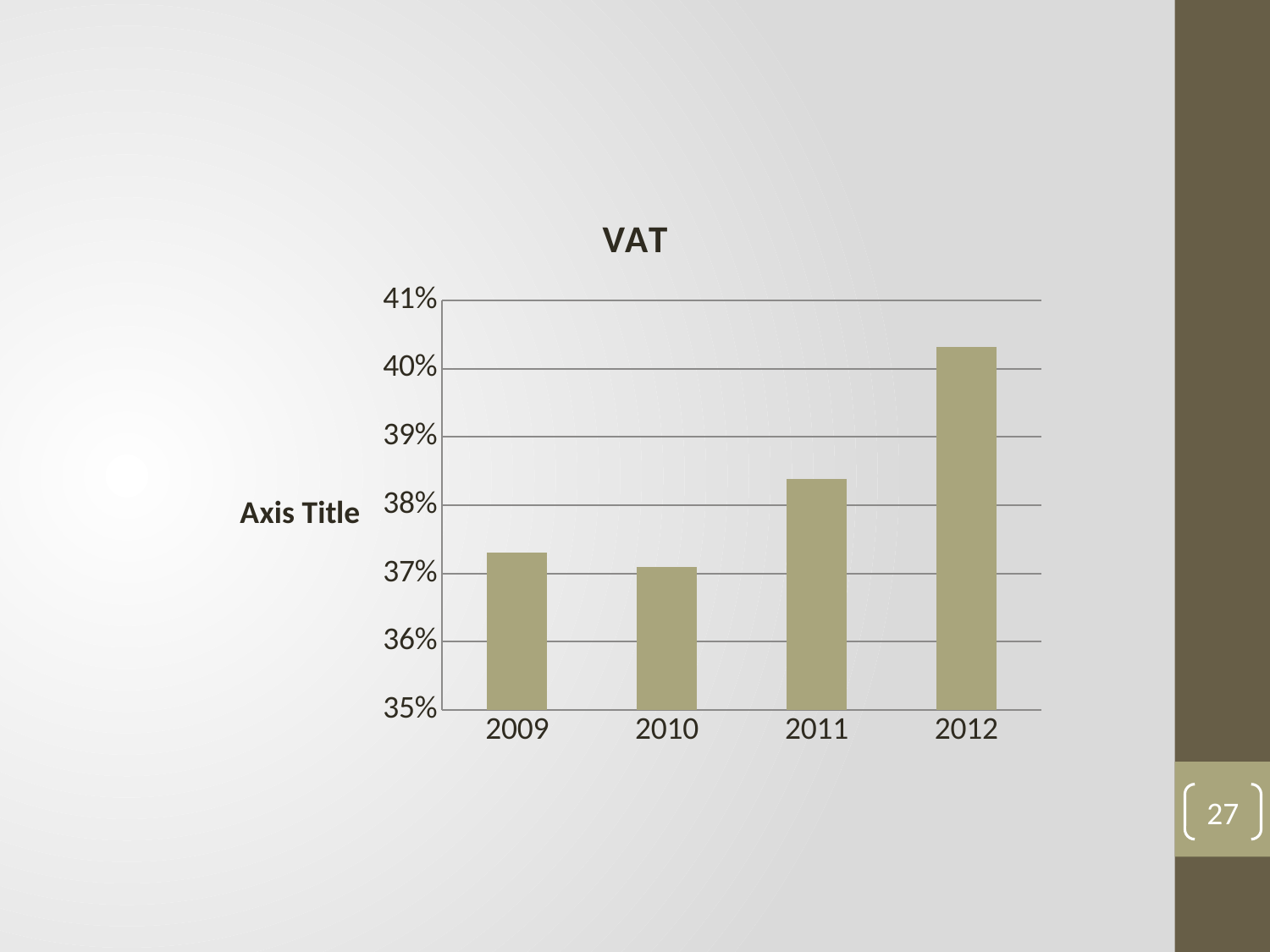
What type of chart is shown on the slide? Bar chart What label is shown on the vertical axis of the chart? Axis Title Is the value for 2011 greater or less than 39%? less Is the value for 2012 greater or less than 40%? greater Is the value for 2010 greater or less than 38%? less Which is larger, the value for 2011 or the value for 2009? 2011 Which year has the highest value in the VAT chart? 2012 How many years are shown on the x axis of the VAT chart? 4 What is the title of the chart? VAT Do the values rise or fall from 2010 to 2012? rise